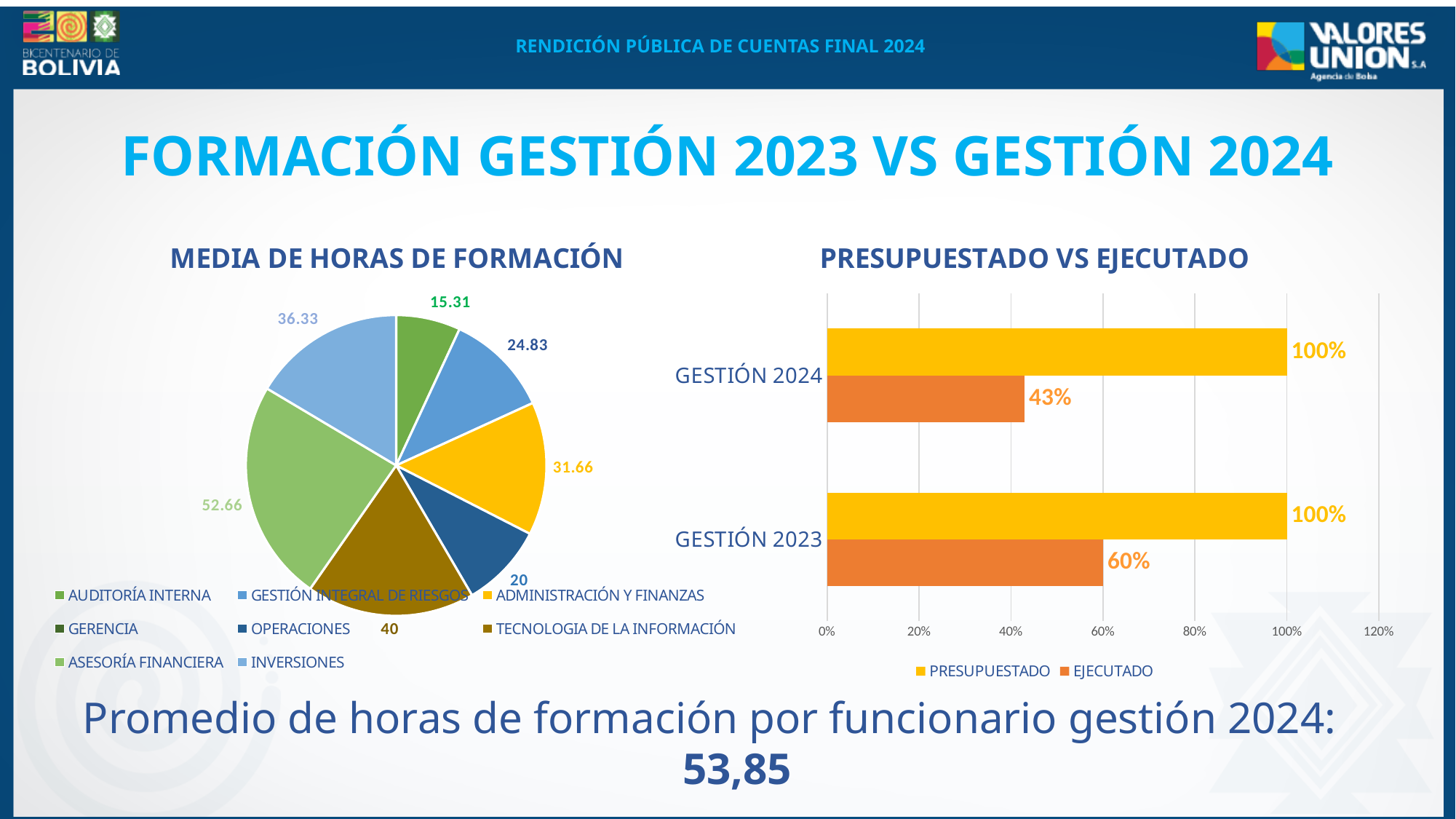
In the MEDIA DE HORAS DE FORMACIÓN pie chart, which of the slices shown is the smallest? AUDITORÍA INTERNA In the MEDIA DE HORAS DE FORMACIÓN pie chart, what is the difference between the values for INVERSIONES and GESTIÓN INTEGRAL DE RIESGOS? 11.5 In the MEDIA DE HORAS DE FORMACIÓN pie chart, which category has the largest slice? ASESORÍA FINANCIERA In the PRESUPUESTADO VS EJECUTADO chart, what is the EJECUTADO value for GESTIÓN 2023? 60% How many series does the legend of the PRESUPUESTADO VS EJECUTADO chart list? 2 What kind of chart is PRESUPUESTADO VS EJECUTADO? bar chart In the PRESUPUESTADO VS EJECUTADO chart, what is the EJECUTADO value for GESTIÓN 2024? 43% In the MEDIA DE HORAS DE FORMACIÓN pie chart, what is the value for TECNOLOGIA DE LA INFORMACIÓN? 40 In the PRESUPUESTADO VS EJECUTADO chart, what is the difference between the EJECUTADO values for GESTIÓN 2023 and GESTIÓN 2024? 17% In the MEDIA DE HORAS DE FORMACIÓN pie chart, which is larger: ADMINISTRACIÓN Y FINANZAS or OPERACIONES? ADMINISTRACIÓN Y FINANZAS In the MEDIA DE HORAS DE FORMACIÓN pie chart, what is the value for ASESORÍA FINANCIERA? 52.66 What kind of chart is MEDIA DE HORAS DE FORMACIÓN? pie chart